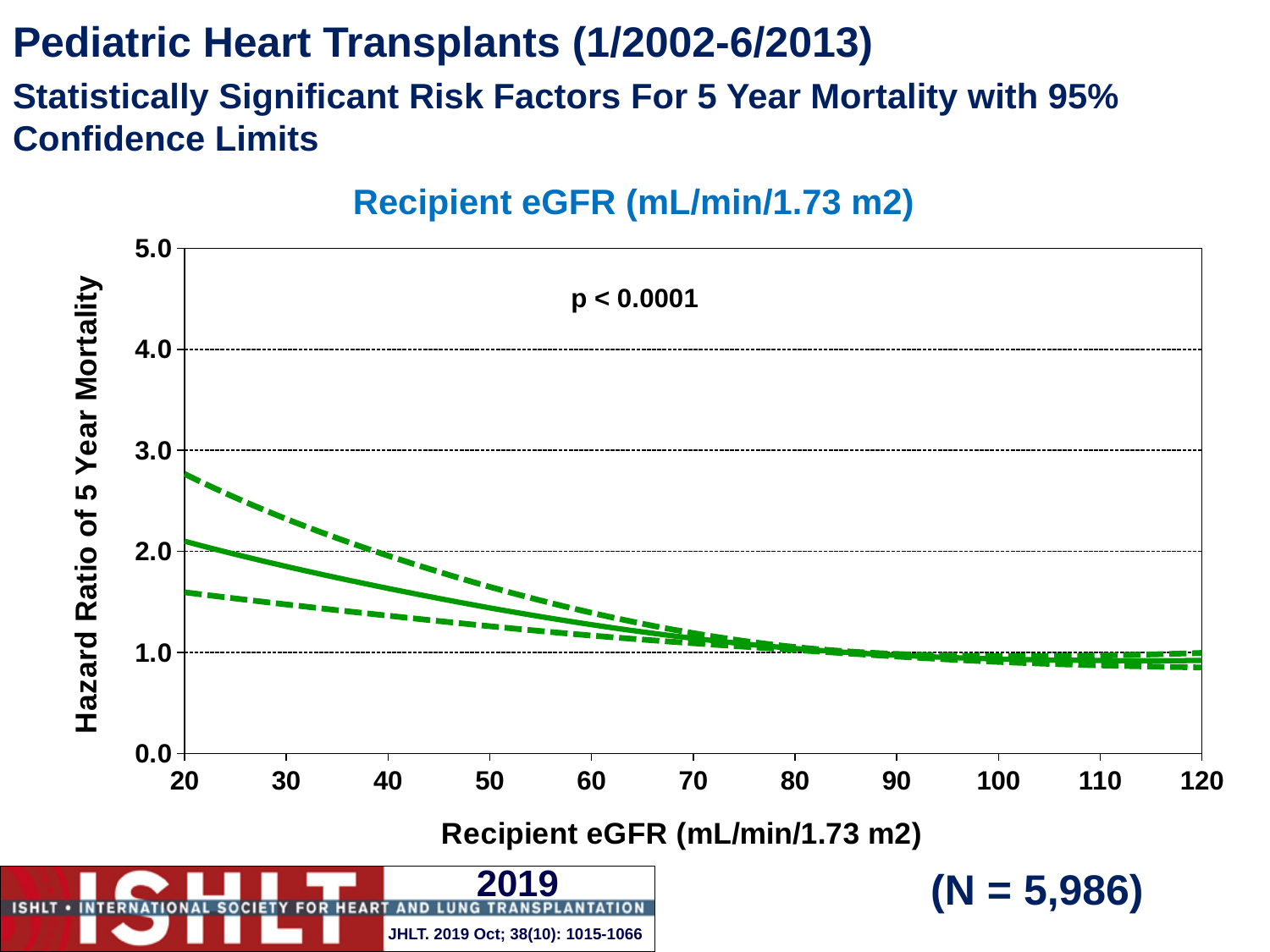
What kind of chart is shown on the slide? line chart Is the hazard ratio on the solid line at a recipient eGFR of 40 greater or less than 2.0? less Is the upper dashed confidence limit at a recipient eGFR of 20 greater or less than 3.0? less At a recipient eGFR of 20, which dashed confidence limit is higher, the upper or the lower? upper How many lines are plotted on the chart? 3 Is the hazard ratio on the solid line larger at a recipient eGFR of 20 or at 100? 20 Is the hazard ratio on the solid line at a recipient eGFR of 60 greater or less than 1.0? greater What p-value is printed on the chart? p < 0.0001 Does the hazard ratio of 5 year mortality rise or fall as recipient eGFR increases from 20 to 120? fall What is the highest value shown on the y axis? 5.0